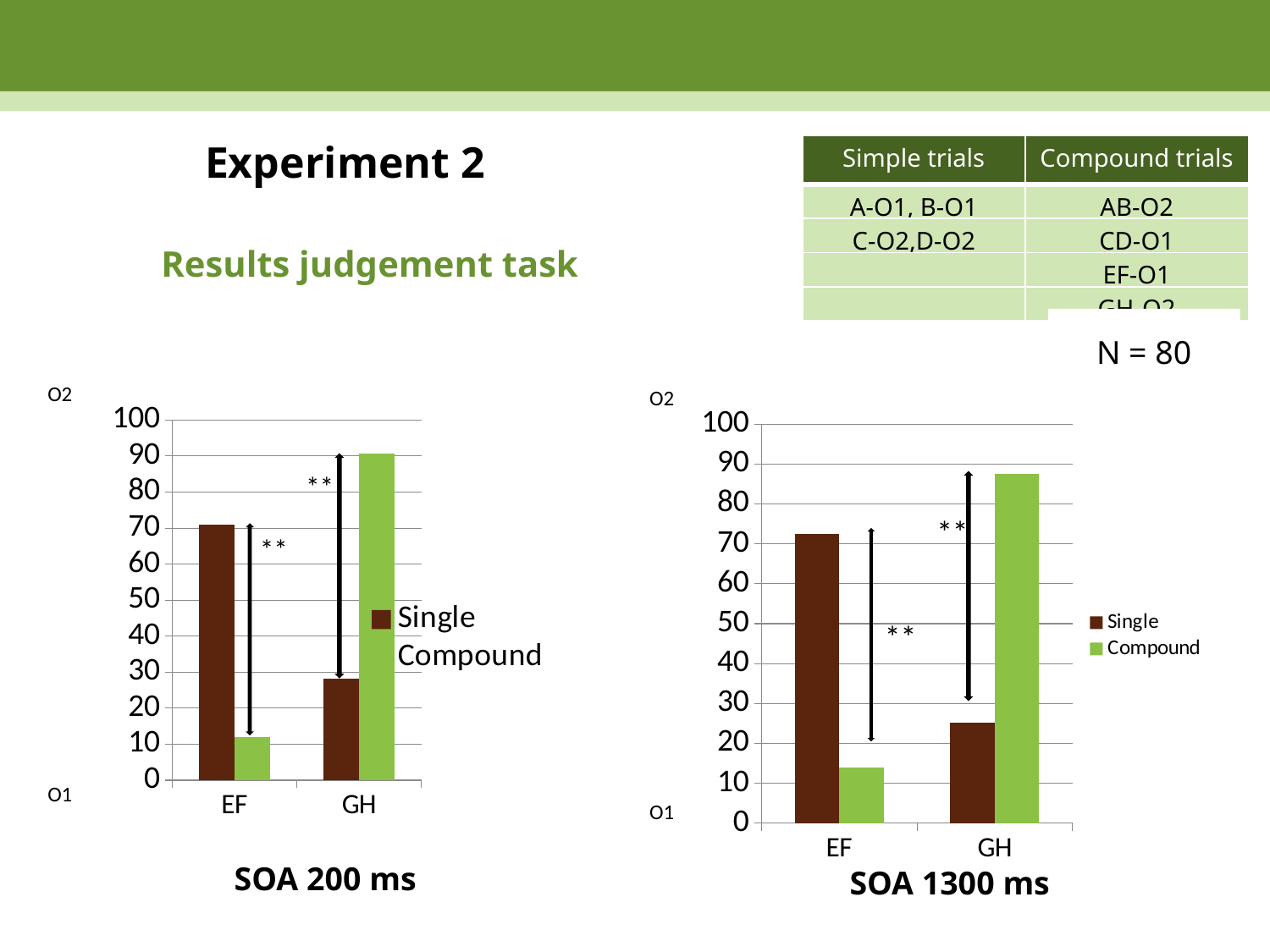
In the SOA 200 ms chart, is the Compound value for EF greater or less than 20? less In the SOA 200 ms chart, for GH, which is larger: Single or Compound? Compound In the SOA 200 ms chart, how many series does the legend list? 2 In the SOA 200 ms chart, is the Single value for EF greater or less than 60? greater In the SOA 1300 ms chart, for EF, which is larger: Single or Compound? Single In the SOA 1300 ms chart, what are the two legend entries? Single and Compound In the SOA 1300 ms chart, is the Compound value for GH greater or less than 80? greater In the SOA 200 ms chart, what kind of chart is shown? bar chart In the SOA 200 ms chart, how many categories are shown on the x axis? 2 In the SOA 1300 ms chart, which bar is the lowest? Compound for EF In the SOA 200 ms chart, which bar is the highest? Compound for GH